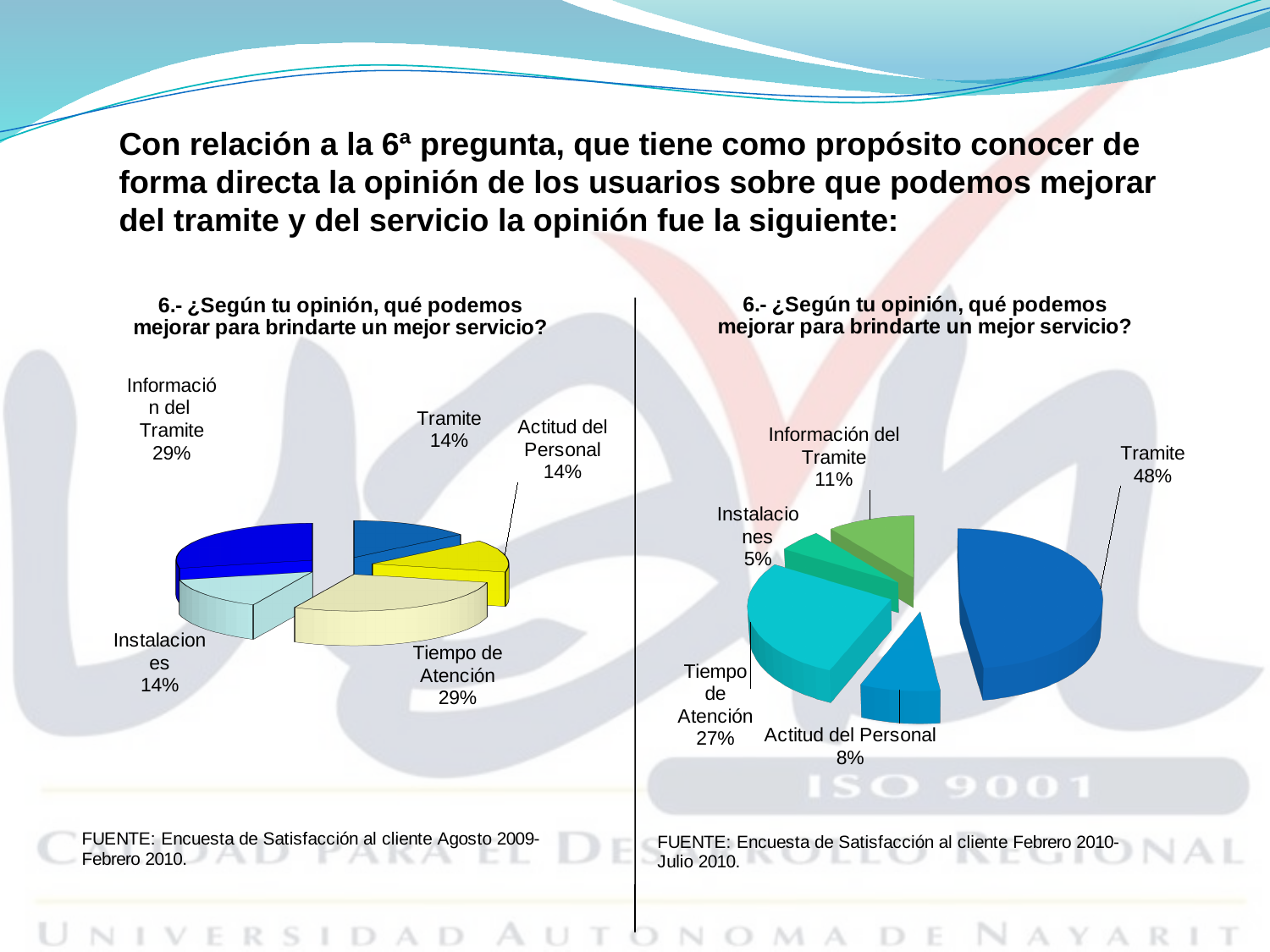
What type of chart is the left chart on the slide? Pie chart What is the title of the right pie chart? 6.- ¿Según tu opinión, qué podemos mejorar para brindarte un mejor servicio? In the right pie chart (Febrero 2010-Julio 2010), what is the difference in percentage points between Tramite and Tiempo de Atención? 21 In the left pie chart (Agosto 2009-Febrero 2010), what percentage is shown for Instalaciones? 14% In the left pie chart (Agosto 2009-Febrero 2010), which is larger: Información del Tramite or Tramite? Información del Tramite How many categories does the right pie chart (Febrero 2010-Julio 2010) show? 5 In the left pie chart (Agosto 2009-Febrero 2010), what percentage is shown for Tiempo de Atención? 29% In the right pie chart (Febrero 2010-Julio 2010), what percentage is shown for Actitud del Personal? 8% What is the difference in percentage points for Tramite between the right chart (Febrero 2010-Julio 2010) and the left chart (Agosto 2009-Febrero 2010)? 34 In the right pie chart (Febrero 2010-Julio 2010), which category has the smallest share? Instalaciones In the right pie chart (Febrero 2010-Julio 2010), what percentage is shown for Tramite? 48% In the right pie chart (Febrero 2010-Julio 2010), which category has the largest share? Tramite